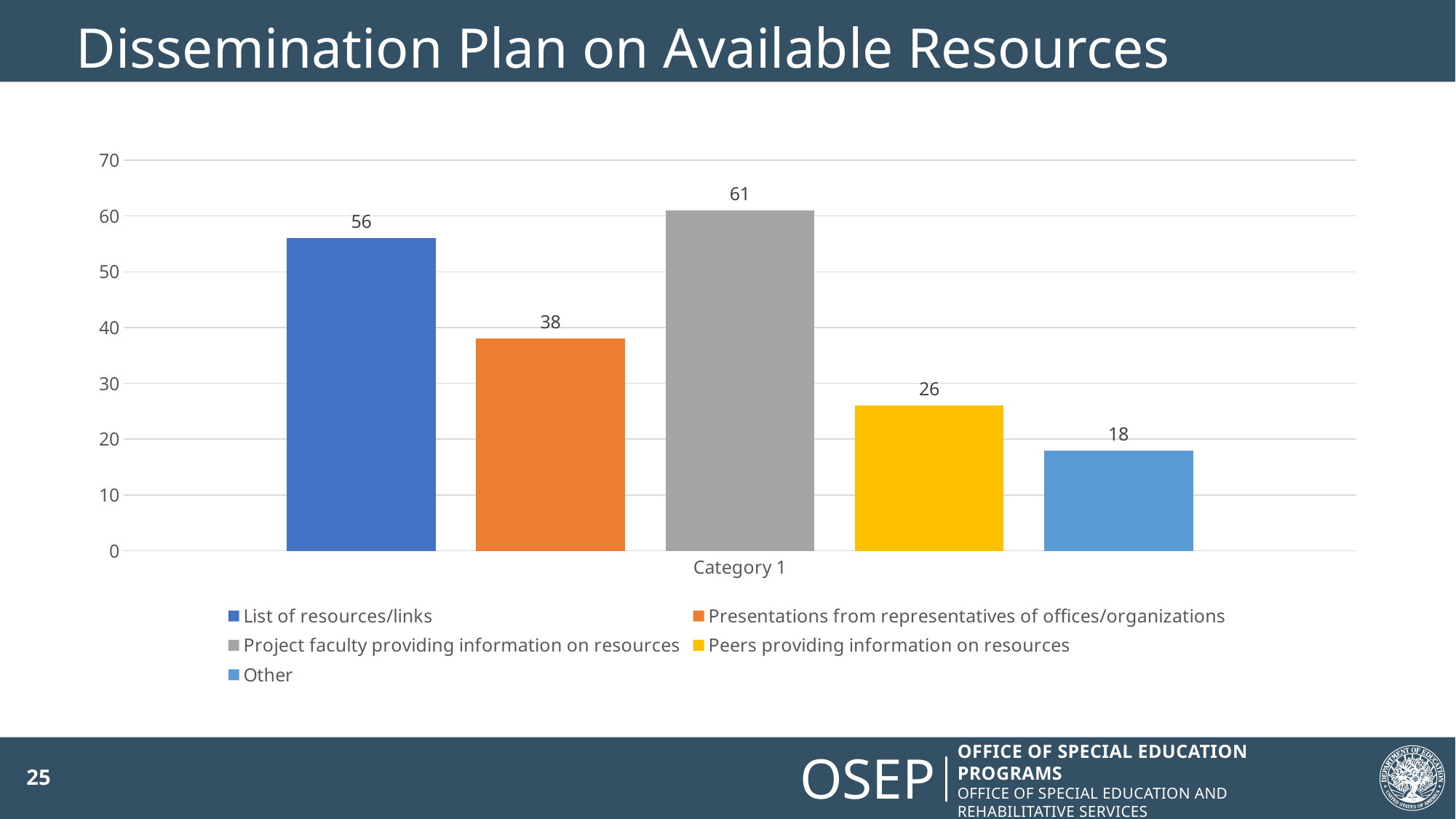
How many series does the legend list? 5 Which is larger, the value for Presentations from representatives of offices/organizations or the value for Peers providing information on resources? Presentations from representatives of offices/organizations What kind of chart is shown on the slide? Bar chart What is the value for Project faculty providing information on resources? 61 What is the difference between the values for Project faculty providing information on resources and List of resources/links? 5 What is the value for List of resources/links? 56 Which series has the lowest value? Other What is the value for Other? 18 What is the value for Peers providing information on resources? 26 Which series has the highest value? Project faculty providing information on resources What is the title of the slide containing the chart? Dissemination Plan on Available Resources What is the value for Presentations from representatives of offices/organizations? 38